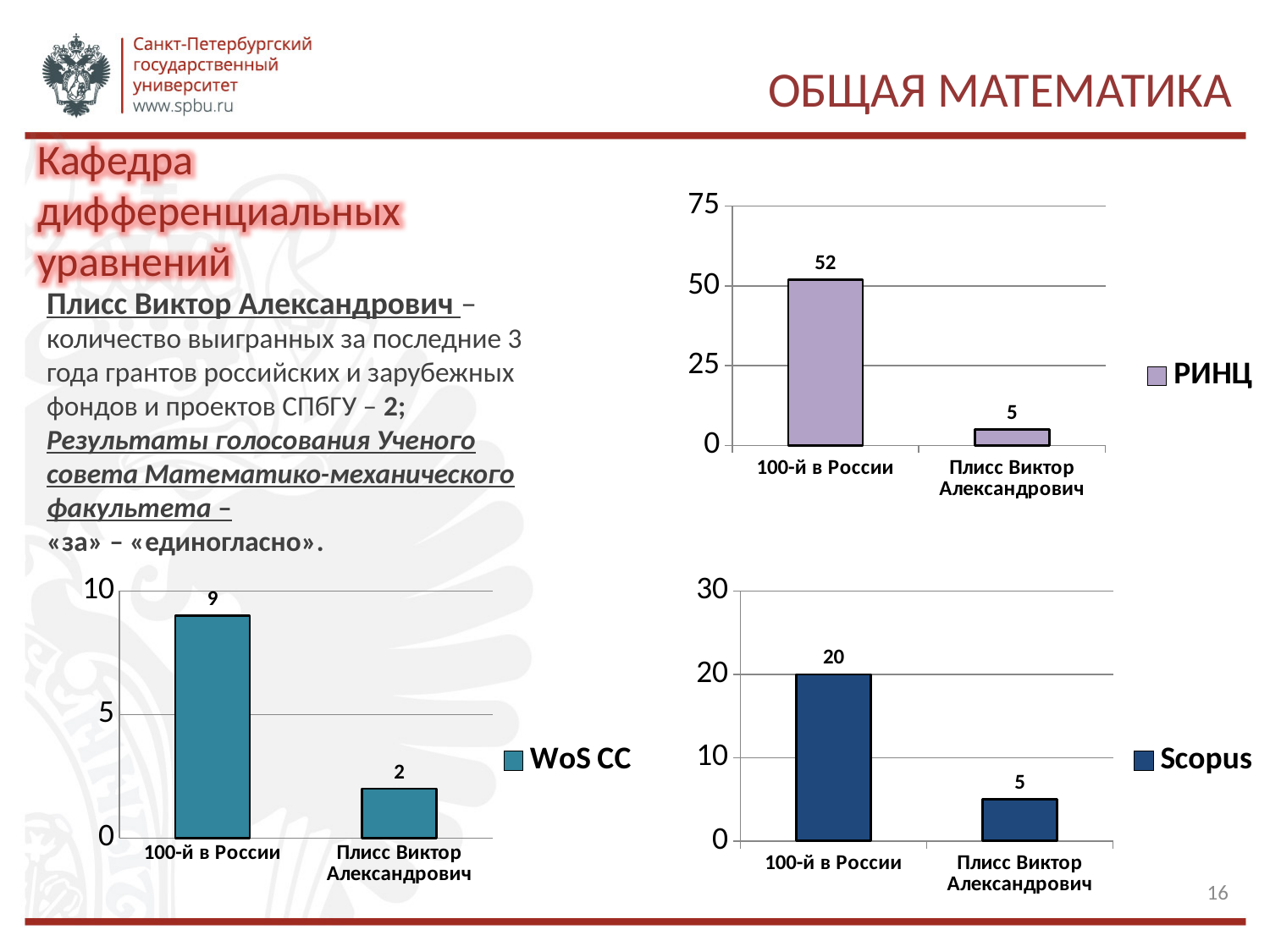
In the Scopus chart (bottom right), what is the difference between the values for 100-й в России and Плисс Виктор Александрович? 15 In the РИНЦ chart (top right), what is the value for Плисс Виктор Александрович? 5 In the WoS CC chart (bottom left), what is the value for 100-й в России? 9 In the РИНЦ chart (top right), what is the difference between the values for 100-й в России and Плисс Виктор Александрович? 47 What kind of chart is the РИНЦ chart (top right)? bar chart In the Scopus chart (bottom right), what is the value for Плисс Виктор Александрович? 5 In the WoS CC chart (bottom left), which category has the highest value? 100-й в России In the Scopus chart (bottom right), which category has the lowest value? Плисс Виктор Александрович In the WoS CC chart (bottom left), what is the value for Плисс Виктор Александрович? 2 In the РИНЦ chart (top right), what is the value for 100-й в России? 52 How many categories does the WoS CC chart (bottom left) show? 2 In the Scopus chart (bottom right), what is the value for 100-й в России? 20